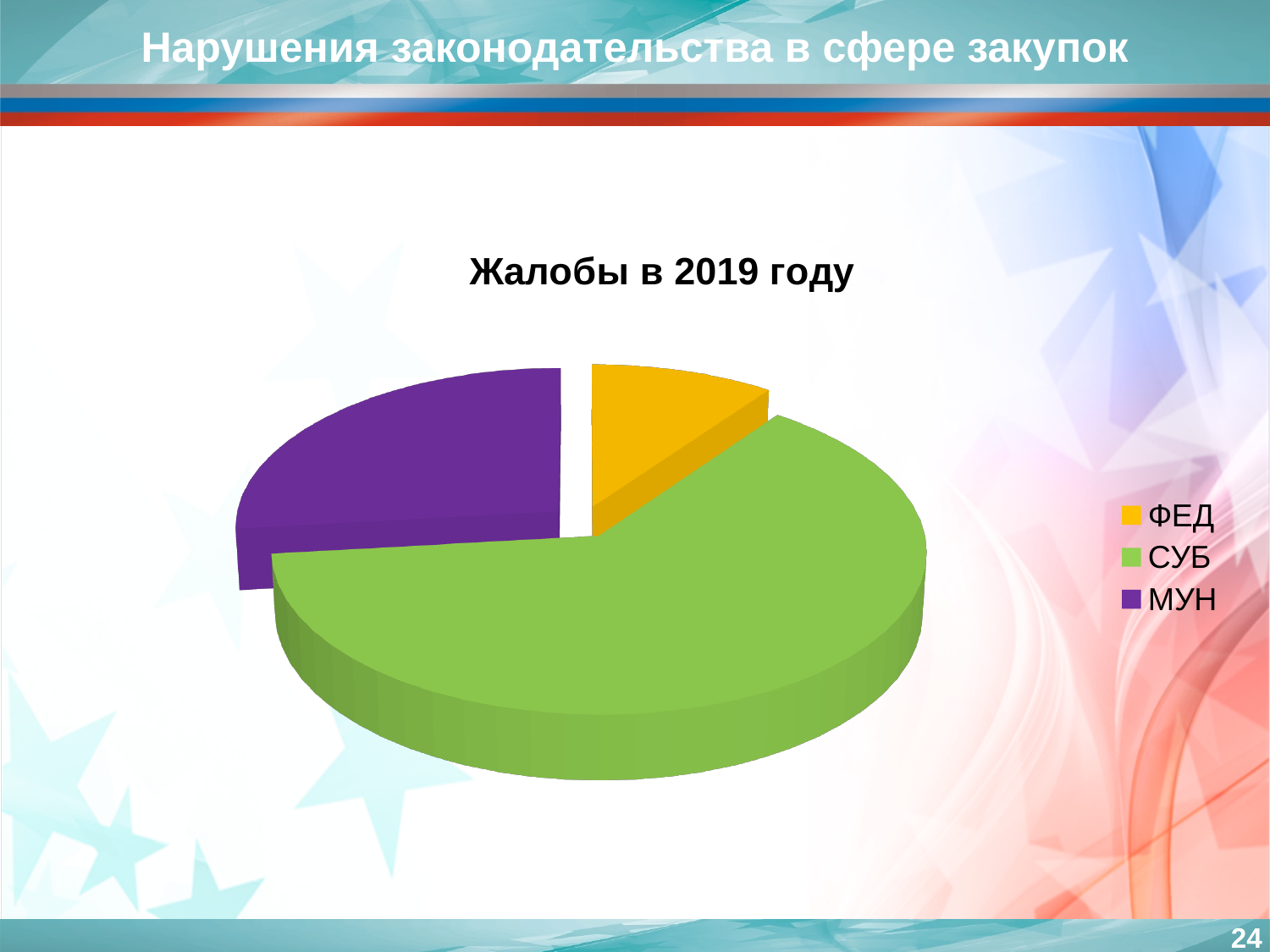
How many entries does the legend list? 3 Which colour represents the СУБ category in the chart? green How many slices does the pie chart have? 3 Which category has the smallest slice of the pie? ФЕД What is the title of the chart? Жалобы в 2019 году What kind of chart is shown on the slide? pie chart Which slice is larger, СУБ or МУН? СУБ Which category has the largest slice of the pie? СУБ Which slice is larger, МУН or ФЕД? МУН